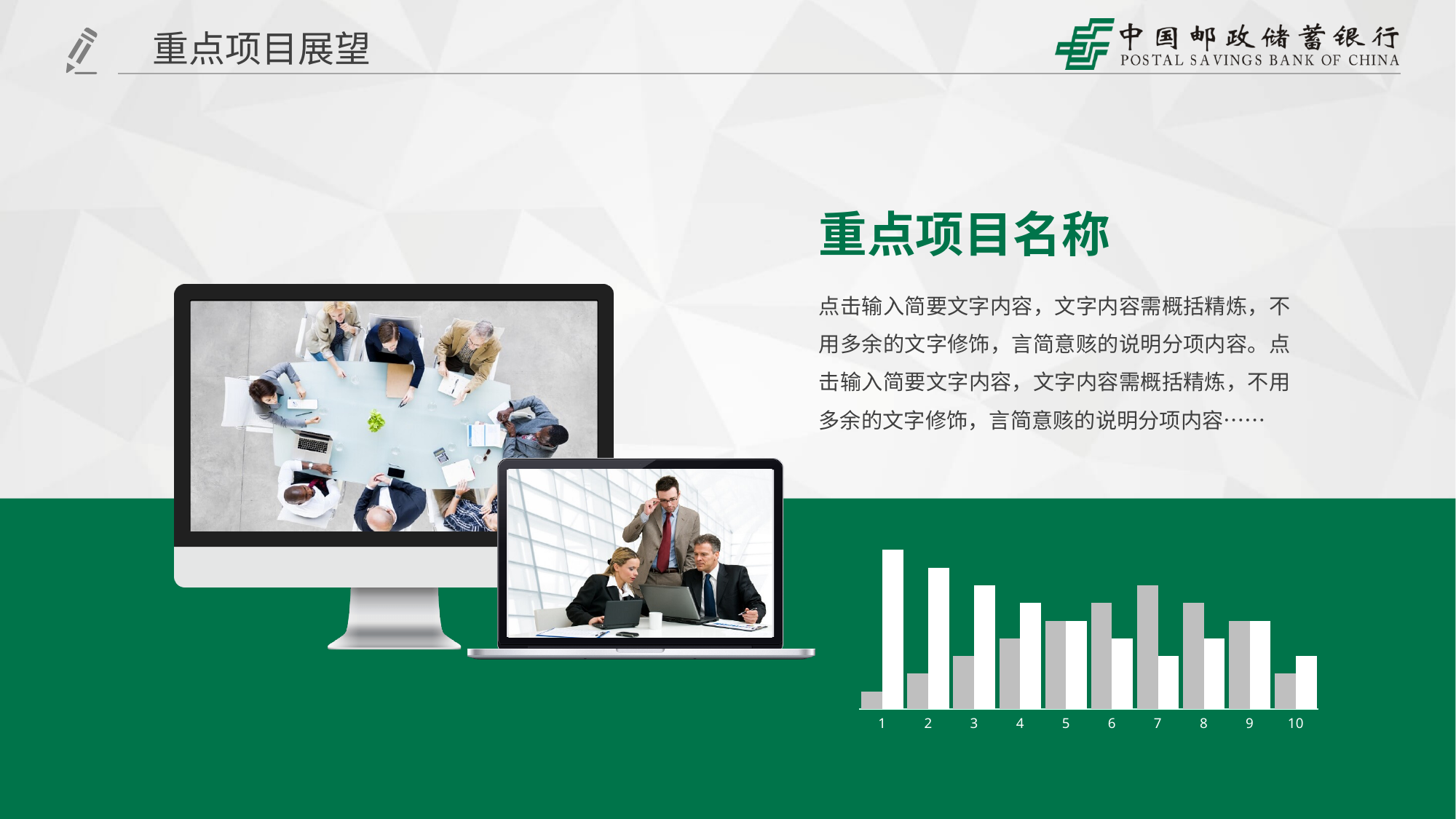
Which category has the tallest white bar in the bar chart? 1 Which category has the tallest gray bar in the bar chart? 7 What two colours are used for the bars in the bar chart? white and gray In the bar chart, do the gray bars rise or fall from category 1 to category 7? rise In the bar chart, is the gray bar for category 7 taller or shorter than the gray bar for category 2? taller Which category has the shortest gray bar in the bar chart? 1 What is the label of the first category on the x axis of the bar chart? 1 How many categories are shown on the x axis of the bar chart? 10 In the bar chart, do the white bars rise or fall from category 1 to category 5? fall What kind of chart is shown at the bottom right of the slide? bar chart In the bar chart, is the white bar for category 1 taller or shorter than the white bar for category 10? taller